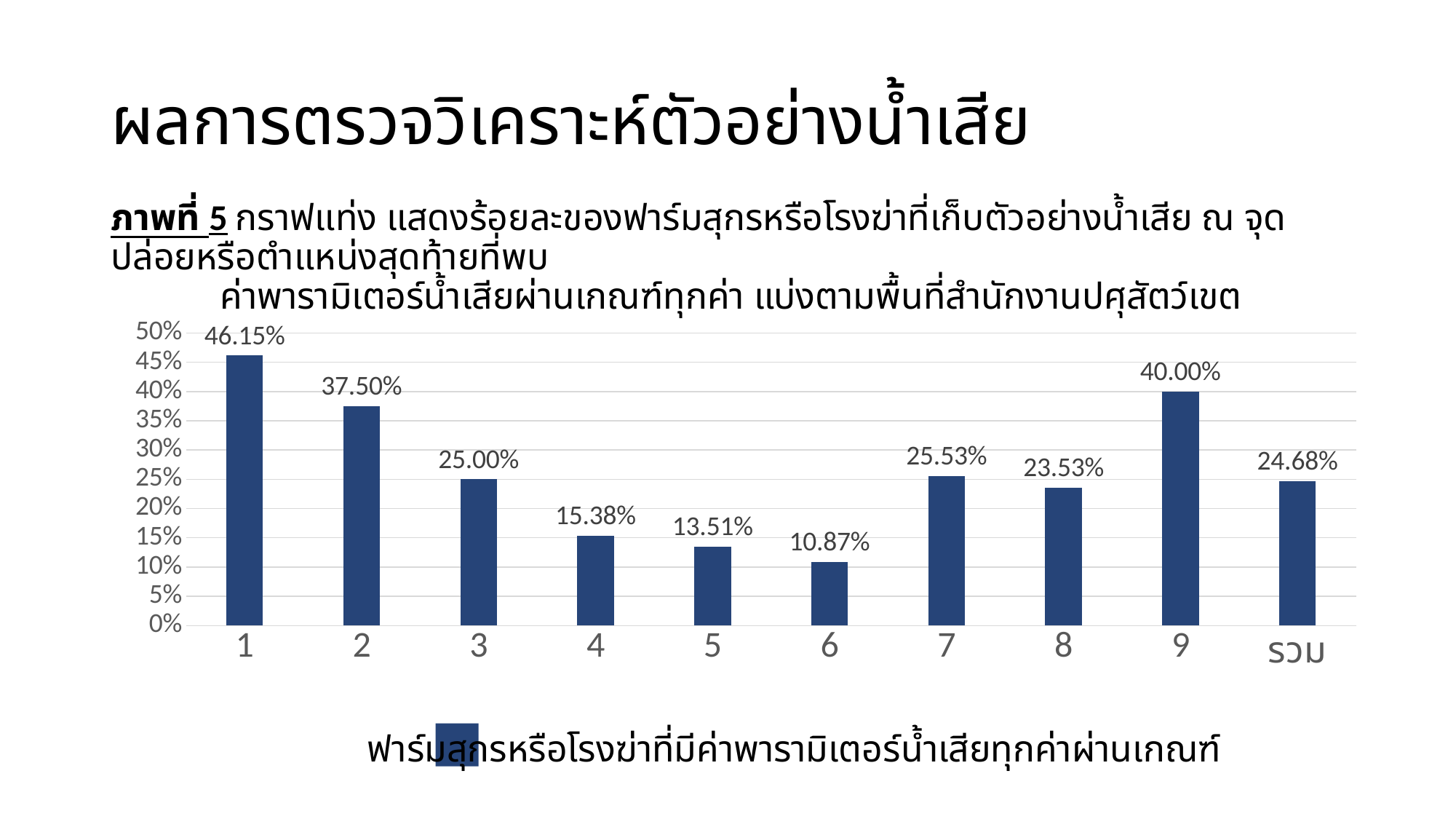
Which category has the lowest value? 6 Which is larger, the value for category 4 or the value for category 5? 4 Is the value for category 9 greater or less than 35%? greater What kind of chart is shown on the slide? bar chart What is the difference between the values for category 1 and category 9? 6.15% How many categories are shown on the x axis? 10 Which category has the highest value? 1 What is the difference between the values for category 2 and category 3? 12.50% What is the value for category 1? 46.15% What is the value for category 6? 10.87% What is the value for the category labelled รวม? 24.68% How many series does the legend list? 1